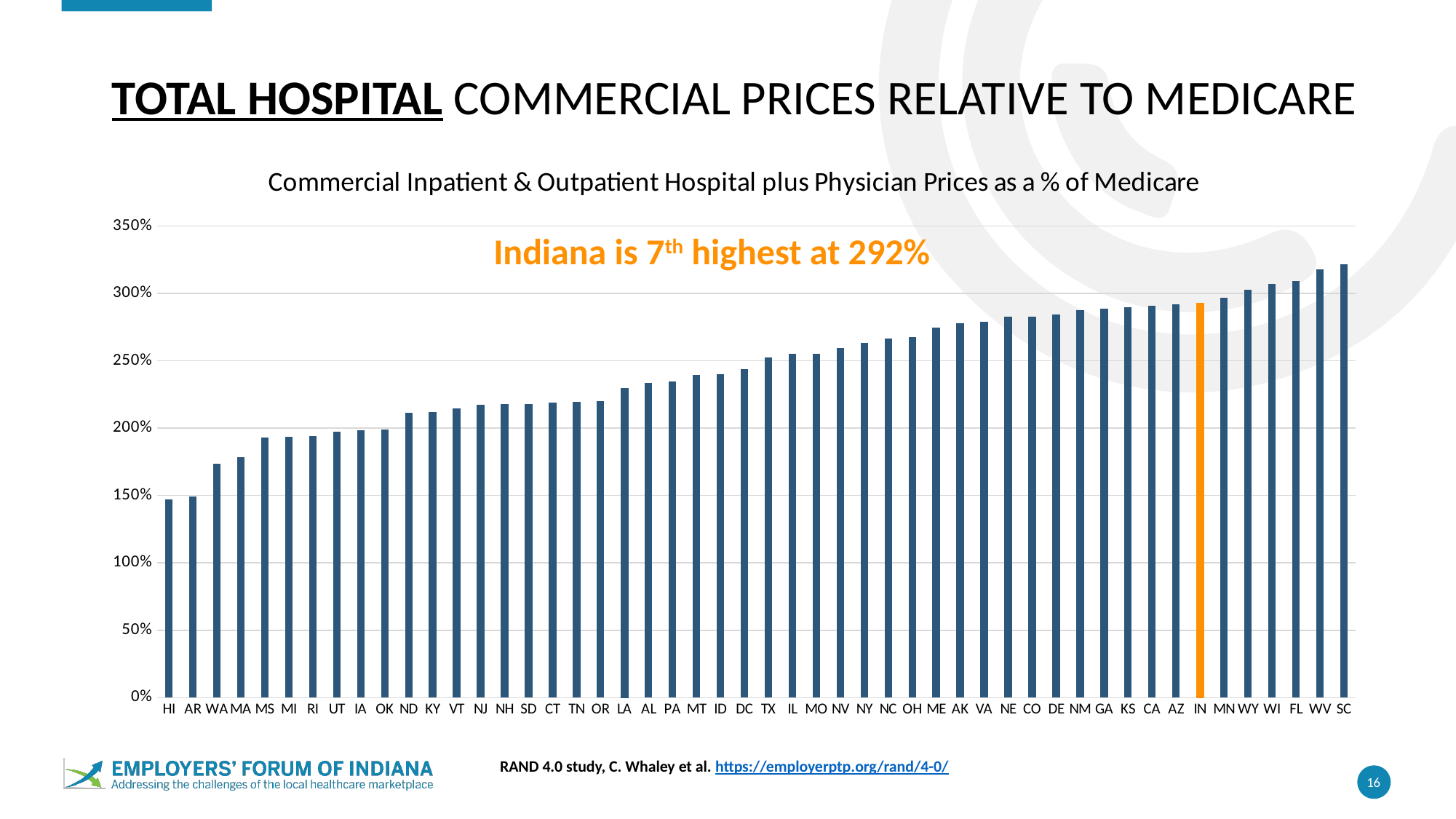
What colour is the bar for IN (Indiana) in the chart? Orange How many states (categories) are plotted in the chart? 50 Is the value for HI greater or less than 150%? less Is the value for SC greater or less than 300%? greater Which state has the highest commercial price relative to Medicare in the chart? SC Is the value for WA greater or less than 200%? less Do the values rise or fall moving from left to right along the x axis? Rise Which state has the lowest commercial price relative to Medicare in the chart? HI What is the value for IN (Indiana) in the chart? 292% Which has a larger value, OK or TX? TX What kind of chart is shown on the slide? Bar chart